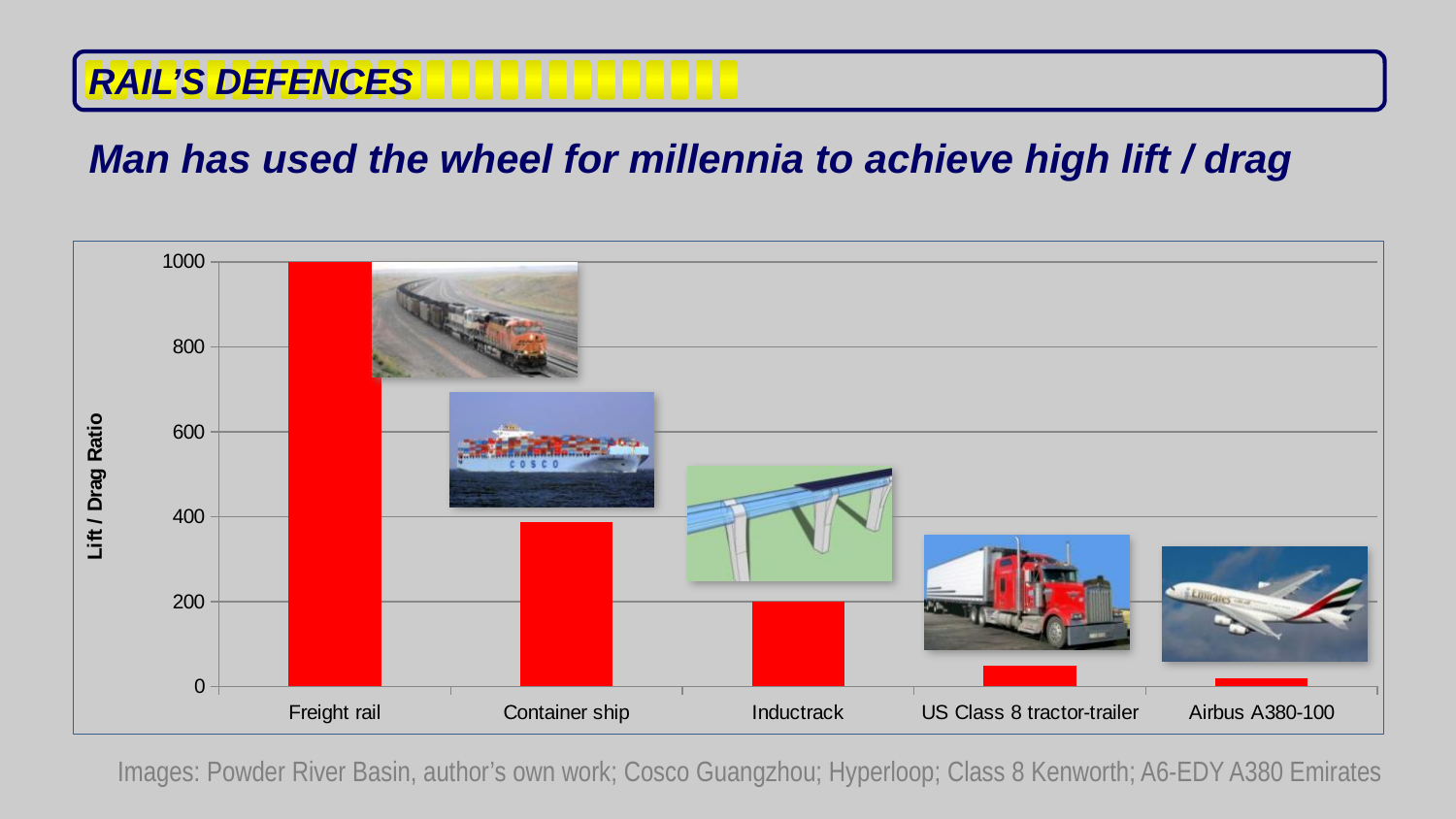
What is the title of the vertical axis? Lift / Drag Ratio Which is larger, the value for Container ship or the value for Inductrack? Container ship What is the Lift / Drag Ratio for Freight rail? 1000 Which category has the highest Lift / Drag Ratio? Freight rail Do the values rise or fall moving from left to right along the x axis? fall Which category has the lowest Lift / Drag Ratio? Airbus A380-100 What kind of chart is shown on the slide? bar chart Is the value for US Class 8 tractor-trailer greater or less than 200? less How many categories are plotted on the x axis of the chart? 5 What is the Lift / Drag Ratio for Inductrack? 200 Is the value for Container ship greater or less than 200? greater What colour are the bars in the chart? red